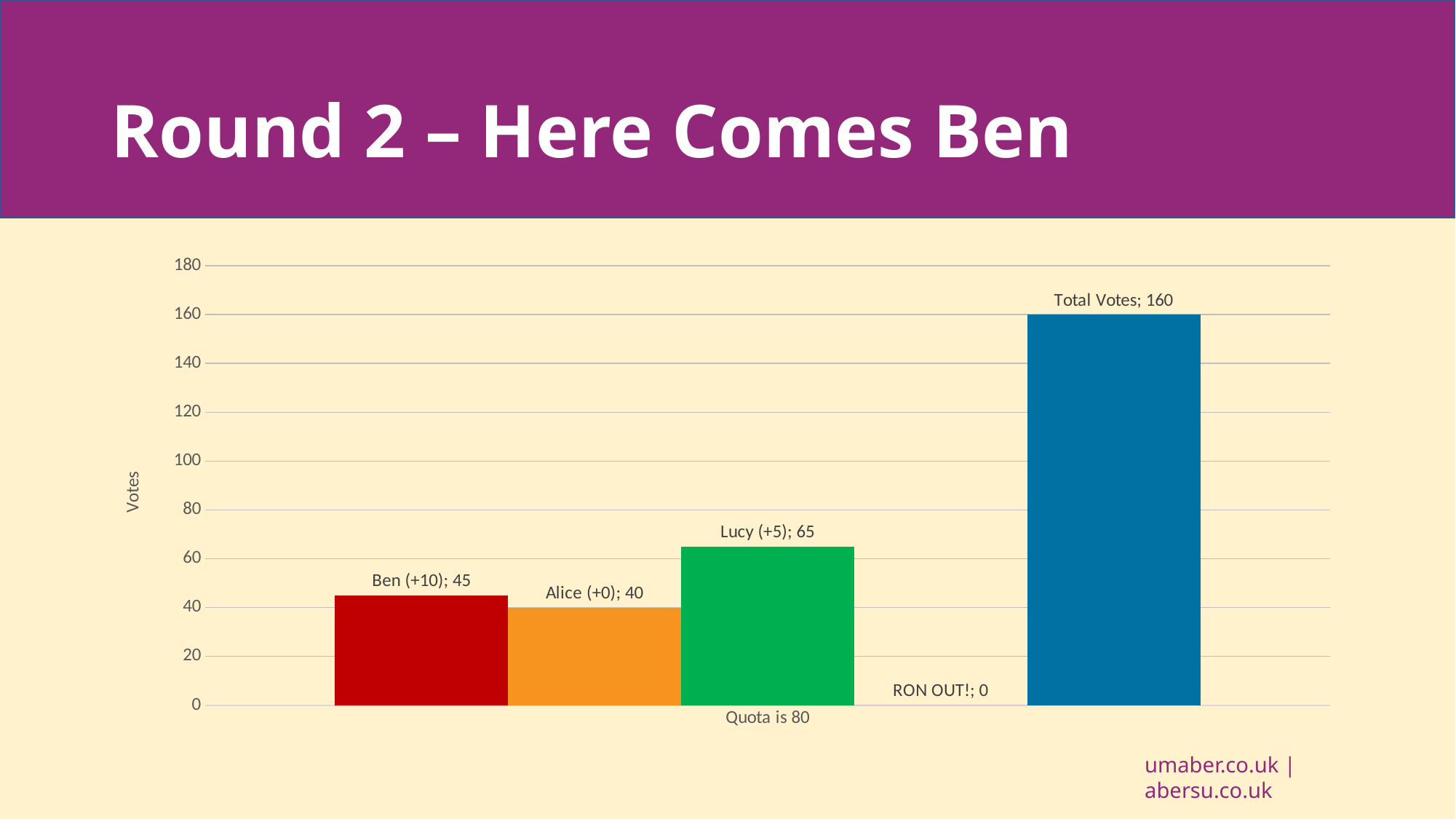
How many votes does Lucy have in the chart? 65 What is the label of the vertical axis of the chart? Votes How many votes does Ben have in the chart? 45 Who has more votes, Ben or Alice? Ben What is the difference between Total Votes and Ben's votes? 115 Which category has the lowest value in the chart? RON OUT! Which candidate among Ben, Alice and Lucy has the most votes? Lucy What is the difference in votes between Lucy and Alice? 25 What is the value shown for Total Votes? 160 What is the value shown for RON OUT!? 0 How many categories are plotted on the x axis of the chart? 5 What type of chart is shown on the slide? Bar chart